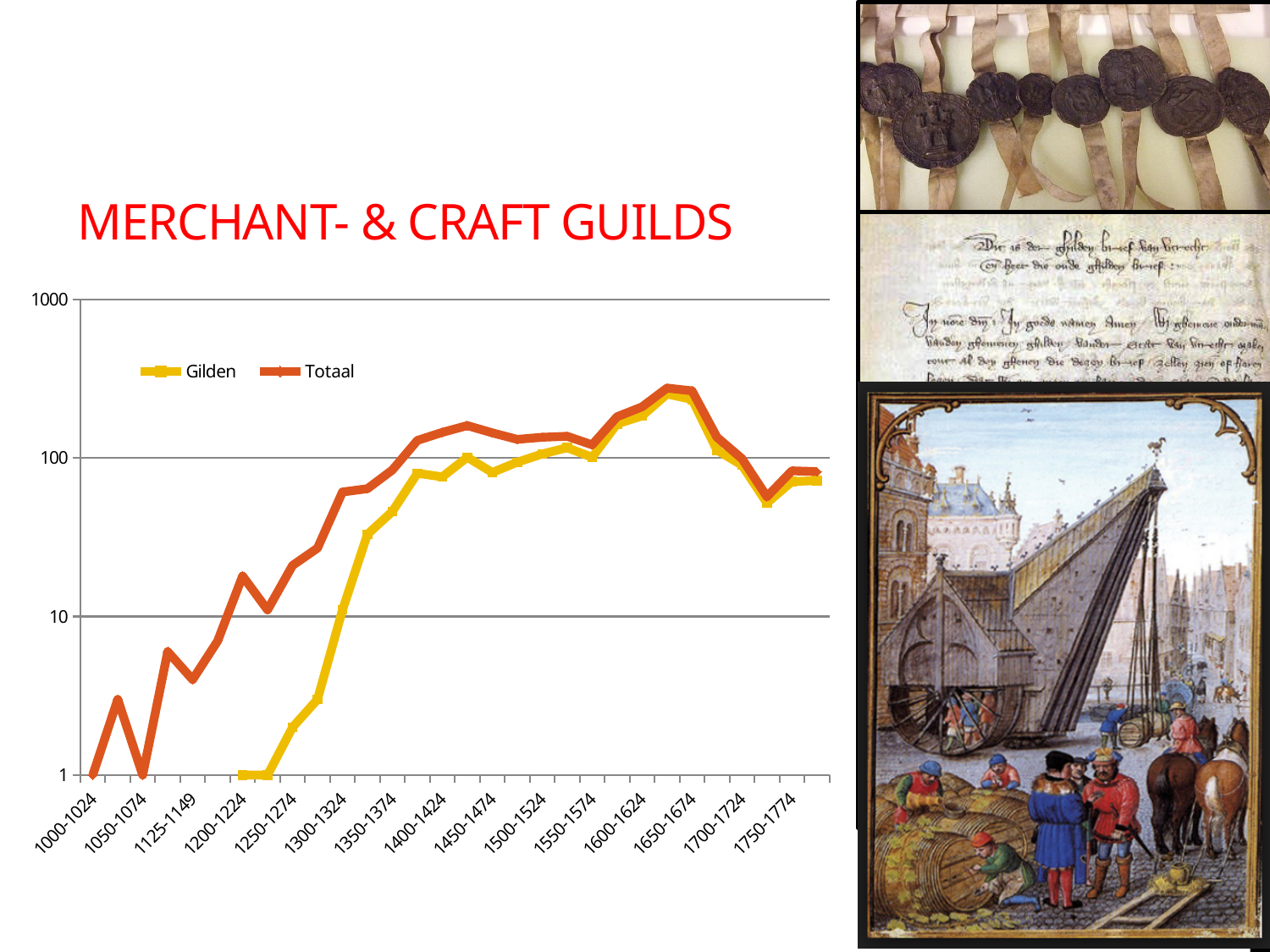
What kind of chart is shown on the slide? line chart Does the Totaal line generally rise or fall from 1000-1024 to 1650-1674? rise Is the Totaal value for 1200-1224 greater or less than 10? greater How many period labels are shown along the x axis of the chart? 15 Which series has the higher value at 1300-1324, Gilden or Totaal? Totaal How many series does the chart legend list? 2 What are the two series named in the chart legend? Gilden and Totaal What colour is the Gilden line in the chart? yellow Is the Gilden value for 1250-1274 greater or less than 10? less Does the Gilden line rise or fall from 1650-1674 to 1700-1724? fall Is the Totaal value for 1650-1674 greater or less than 100? greater